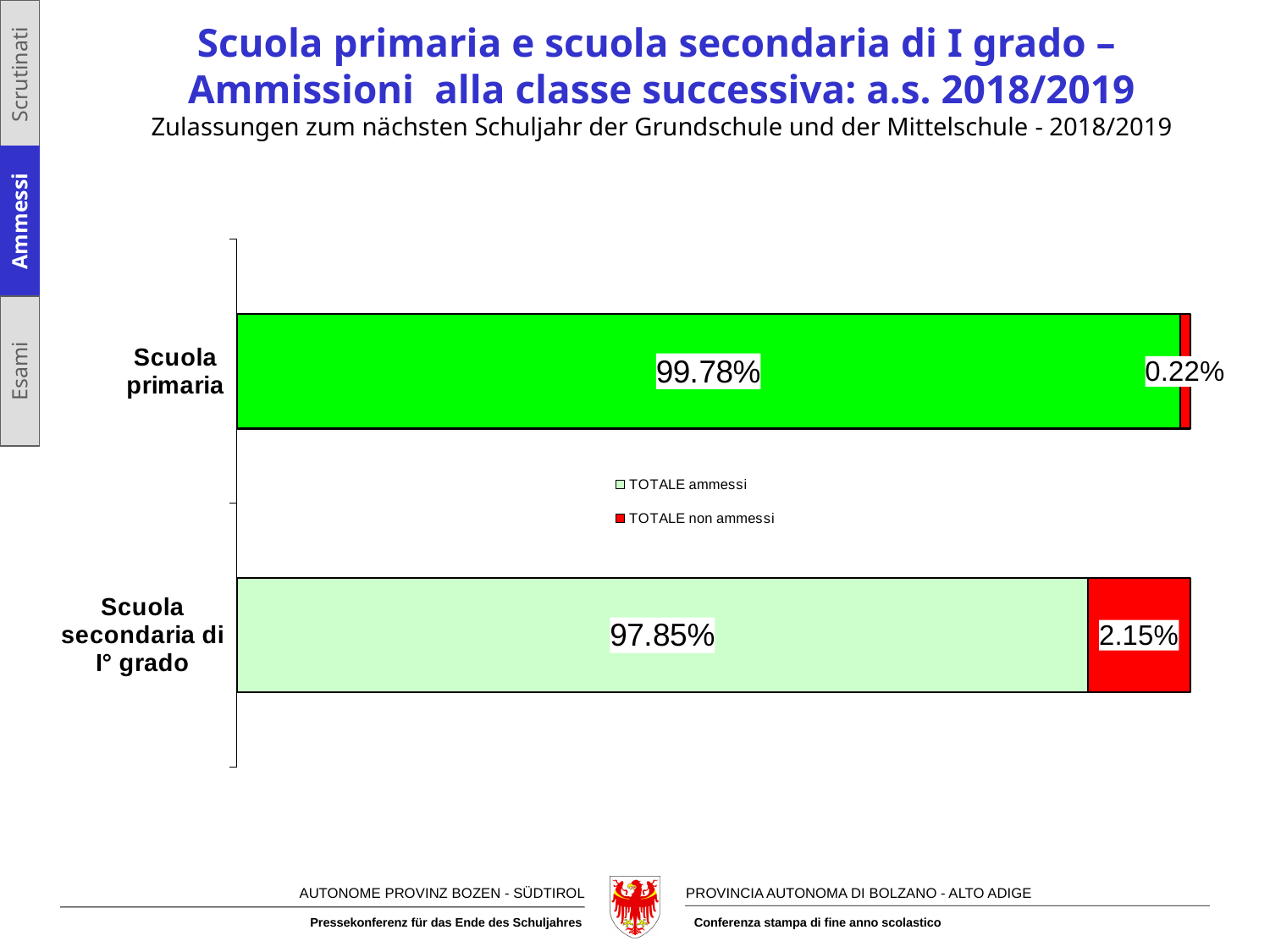
Which category has the higher TOTALE non ammessi value? Scuola secondaria di I° grado How many categories are shown in the chart? 2 Is the TOTALE ammessi value larger for Scuola primaria or for Scuola secondaria di I° grado? Scuola primaria What is the value of TOTALE ammessi for Scuola secondaria di I° grado? 97.85% What is the value of TOTALE ammessi for Scuola primaria? 99.78% What is the value of TOTALE non ammessi for Scuola primaria? 0.22% What is the difference between the TOTALE ammessi values for Scuola primaria and Scuola secondaria di I° grado? 1.93% What is the value of TOTALE non ammessi for Scuola secondaria di I° grado? 2.15% How many series does the legend list? 2 What kind of chart is shown on the slide? Stacked bar chart What is the total of the stacked bar for Scuola secondaria di I° grado? 100% Which category has the lower TOTALE ammessi value? Scuola secondaria di I° grado